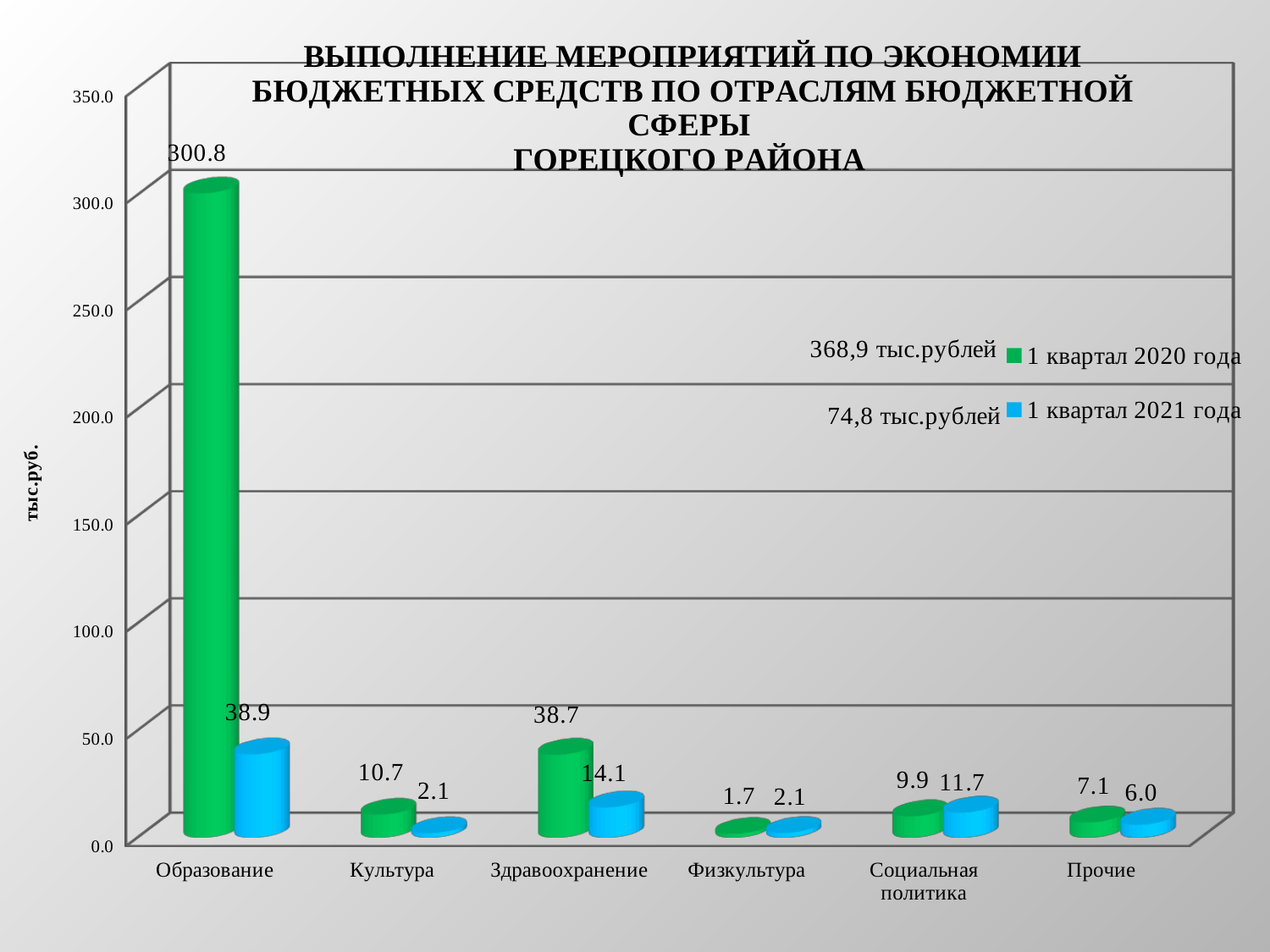
Is the value for Образование in 1 квартал 2020 года greater or less than 250.0? greater How many categories are shown on the x axis? 6 What is the difference between the 1 квартал 2020 года and 1 квартал 2021 года values for Образование? 261.9 Which category has the highest value in 1 квартал 2020 года? Образование What kind of chart is shown on the slide? bar chart Which is larger for Социальная политика: the 1 квартал 2020 года value or the 1 квартал 2021 года value? 1 квартал 2021 года How many series does the legend list? 2 What is the value for Здравоохранение in 1 квартал 2021 года? 14.1 What is the label of the vertical axis? тыс.руб. What is the value for Социальная политика in 1 квартал 2020 года? 9.9 Which category has the lowest value in 1 квартал 2020 года? Физкультура What is the value for Образование in 1 квартал 2020 года? 300.8